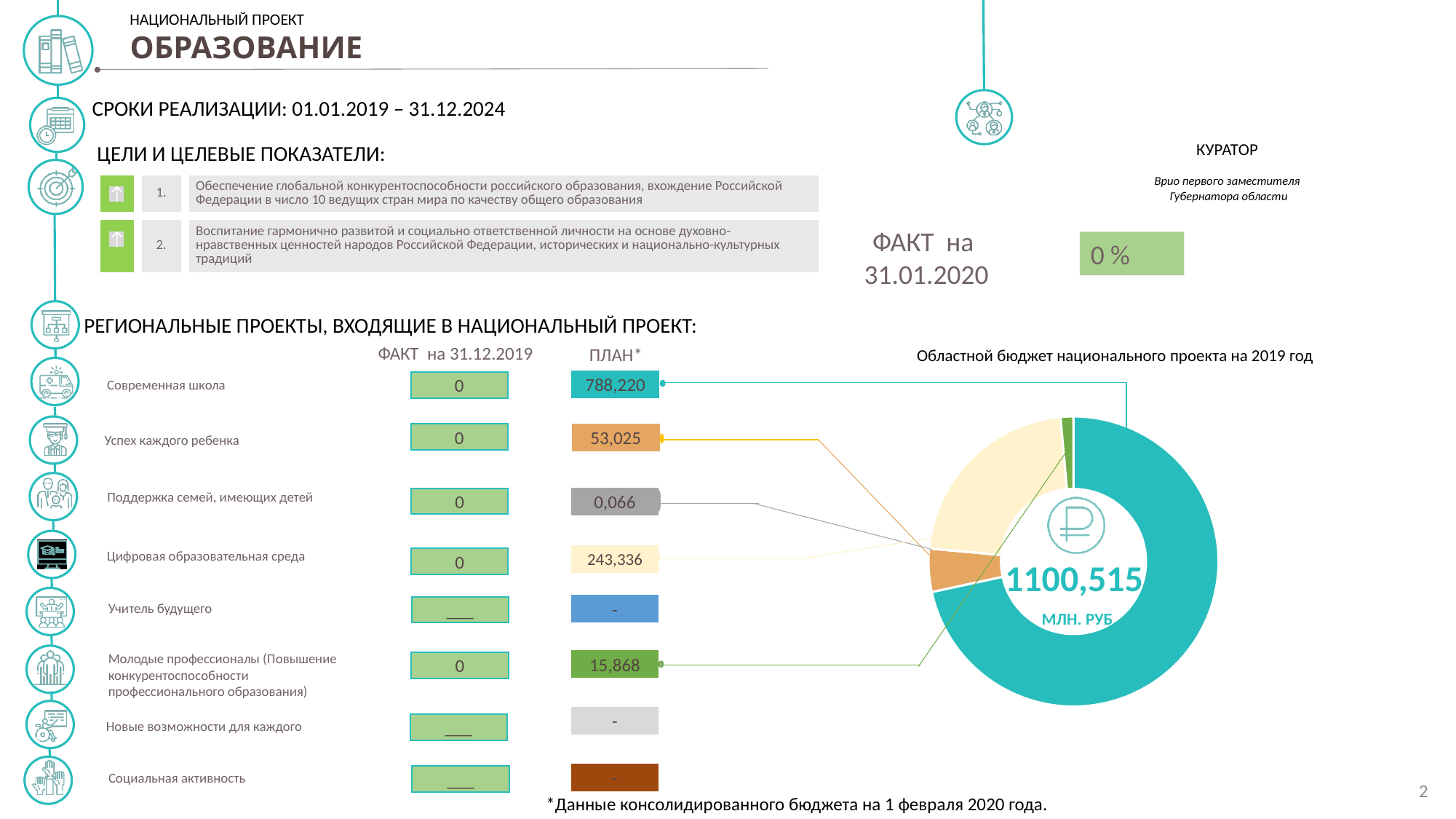
What kind of chart is shown under the title "Областной бюджет национального проекта на 2019 год"? Donut (pie) chart What is the planned budget value (ПЛАН*) for "Современная школа"? 788,220 What colour is the slice of the donut chart representing "Современная школа"? Teal What is the planned budget value (ПЛАН*) for "Молодые профессионалы"? 15,868 What is the difference between the planned budgets of "Успех каждого ребенка" and "Молодые профессионалы"? 37,157 Which has a larger planned budget: "Цифровая образовательная среда" or "Успех каждого ребенка"? Цифровая образовательная среда What is the planned budget value (ПЛАН*) for "Цифровая образовательная среда"? 243,336 What is the planned budget value (ПЛАН*) for "Успех каждого ребенка"? 53,025 Which regional project has the largest slice of the donut chart? Современная школа What total value is printed in the centre of the donut chart? 1100,515 млн. руб Among the projects with a plan value linked to the donut chart, which has the smallest value? Поддержка семей, имеющих детей What is the difference between the planned budgets of "Современная школа" and "Цифровая образовательная среда"? 544,884